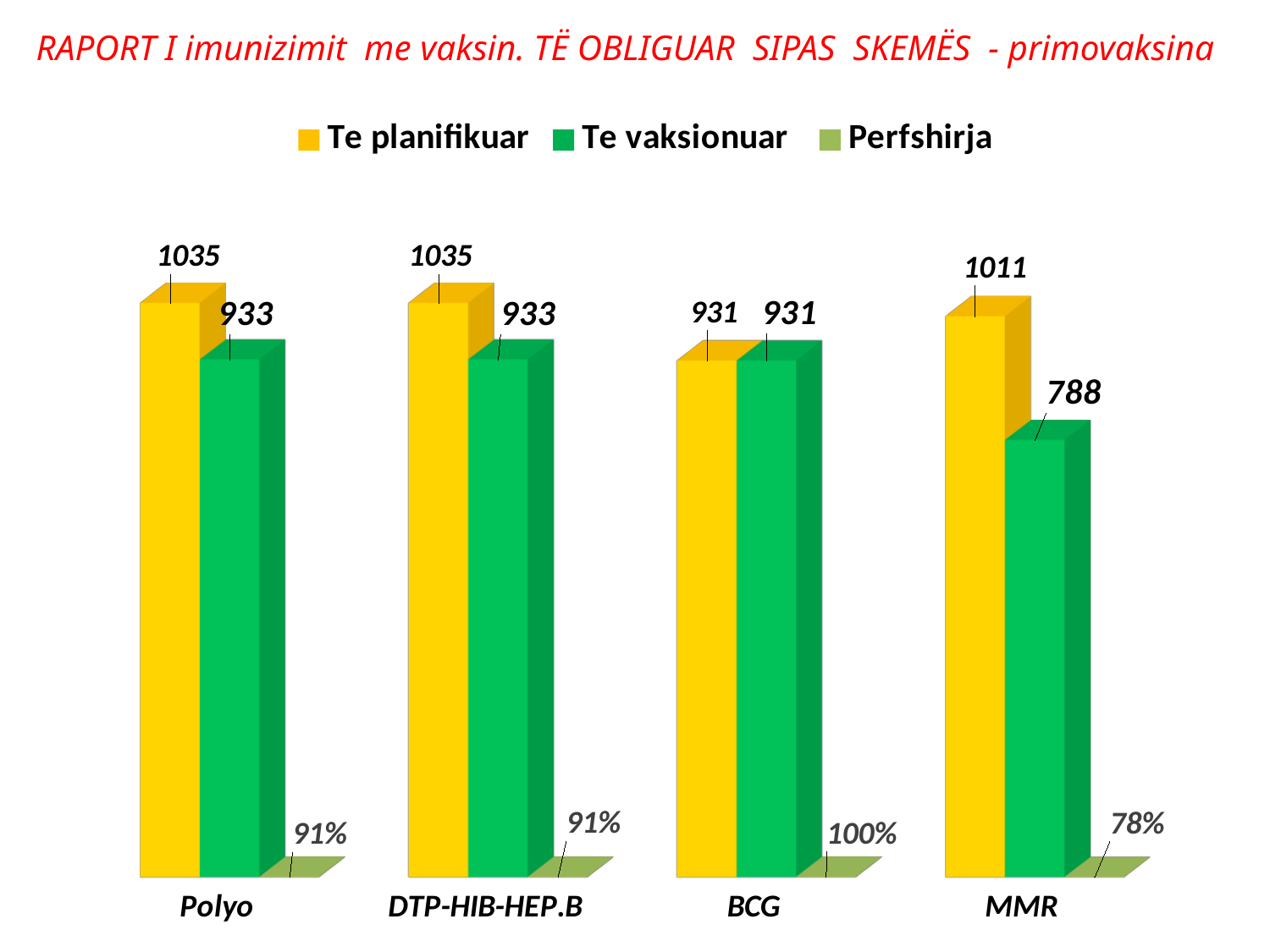
Which category has the lowest 'Te vaksionuar' value? MMR What is the 'Te vaksionuar' value for MMR? 788 How many categories are shown on the x axis? 4 How many series does the legend list? 3 What is the difference between 'Te planifikuar' and 'Te vaksionuar' for MMR? 223 What is the 'Te vaksionuar' value for DTP-HIB-HEP.B? 933 What is the 'Perfshirja' value for BCG? 100% What kind of chart is shown on the slide? Bar chart What is the difference between 'Te planifikuar' and 'Te vaksionuar' for Polyo? 102 Which is larger: the 'Te planifikuar' value for Polyo or the 'Te planifikuar' value for MMR? Polyo Which category has the lowest 'Perfshirja' value? MMR What is the 'Te planifikuar' value for Polyo? 1035